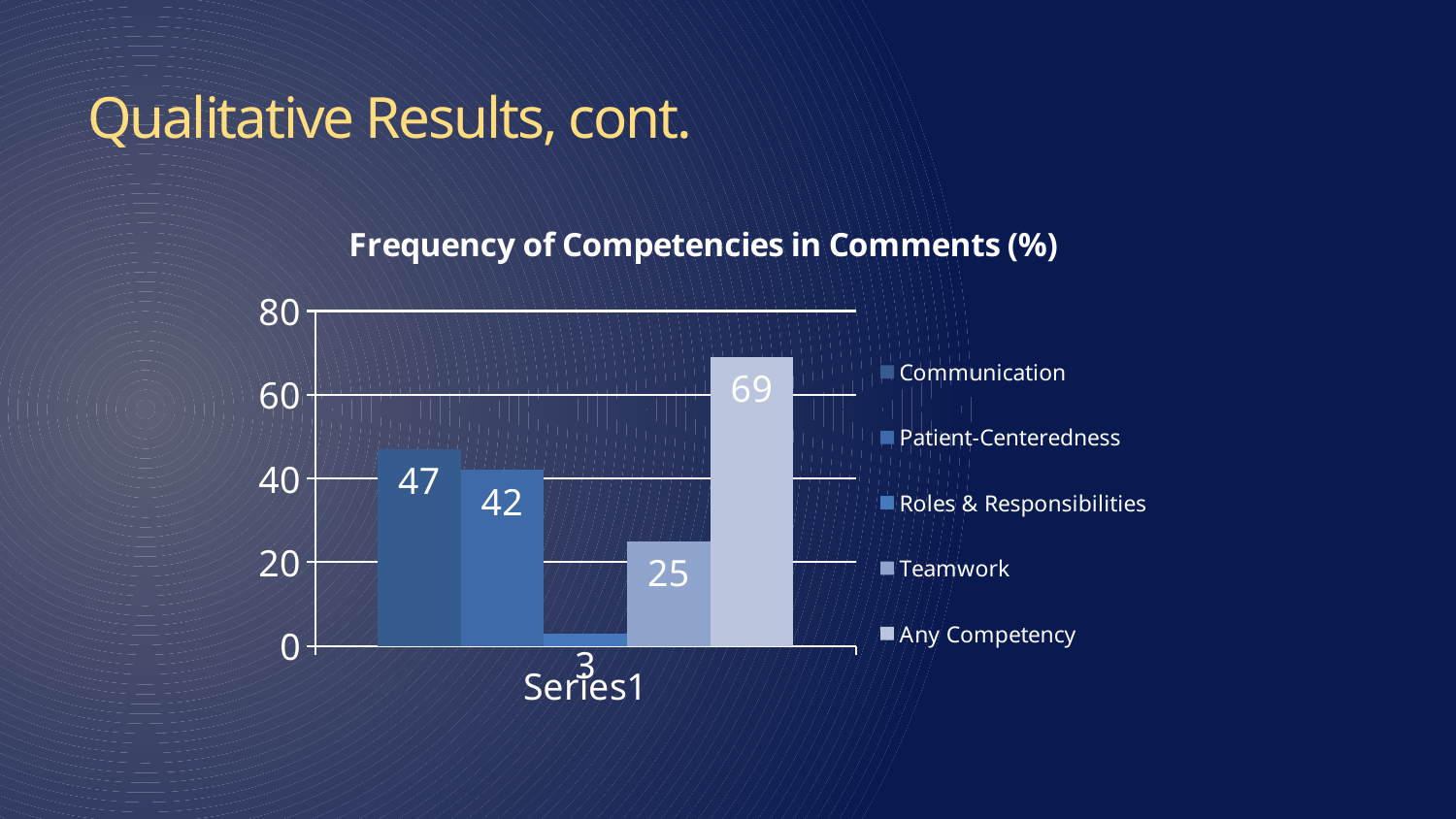
Which is larger, the value for Teamwork or the value for Patient-Centeredness? Patient-Centeredness What is the title of the chart? Frequency of Competencies in Comments (%) What is the value for Roles & Responsibilities? 3 What is the value for Patient-Centeredness? 42 Which competency has the lowest value in the chart? Roles & Responsibilities What is the difference between the values for Communication and Patient-Centeredness? 5 Which competency has the highest value in the chart? Any Competency What is the value for Communication in the Frequency of Competencies in Comments chart? 47 What is the value for Teamwork? 25 How many series does the legend list? 5 What kind of chart is shown on the slide? Bar chart What is the value for Any Competency? 69